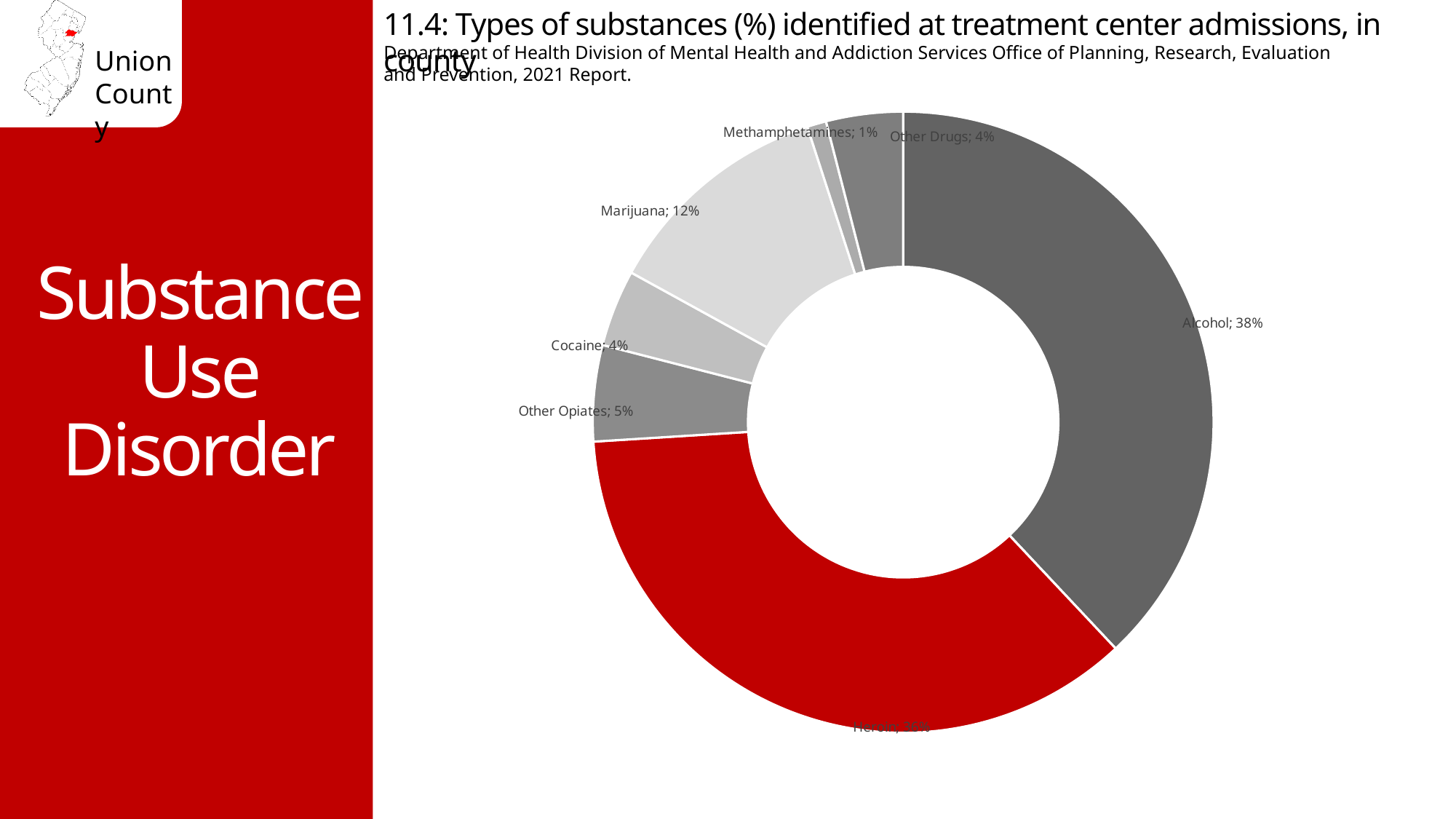
Which substance has the smallest share of admissions? Methamphetamines What percentage is shown for Marijuana? 12% Which substance has the largest share of admissions? Alcohol Which is larger, the share for Other Opiates or the share for Cocaine? Other Opiates What percentage is shown for Heroin? 36% Which slice of the chart is coloured red? Heroin How many substance categories are shown in the chart? 7 What is the difference in percentage points between Alcohol and Marijuana? 26 What percentage is shown for Methamphetamines? 1% What percentage of treatment center admissions identified Alcohol? 38% What type of chart is shown on the slide? Doughnut (pie) chart What percentage is shown for Other Opiates? 5%